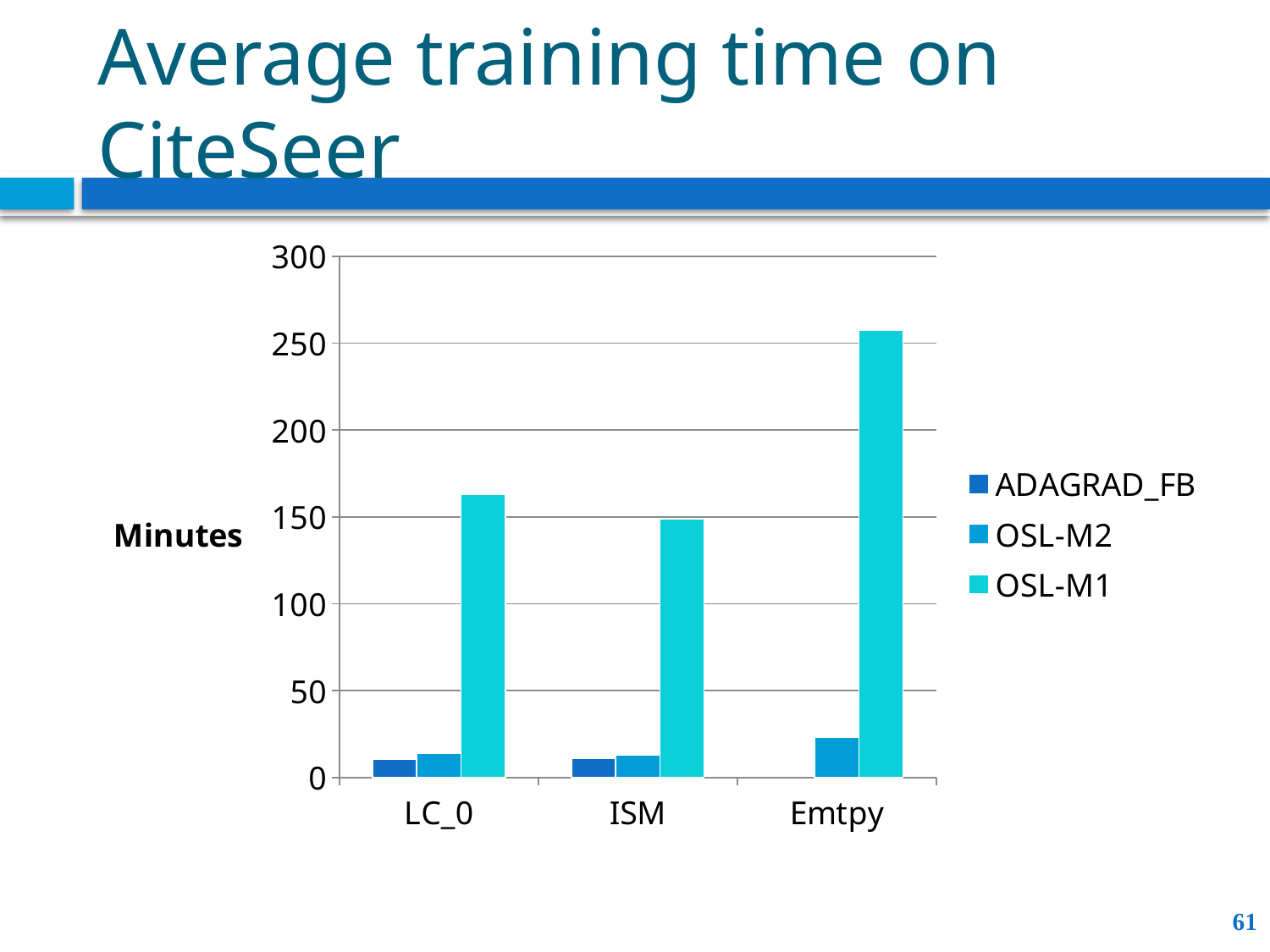
Is the OSL-M1 value for Emtpy greater or less than 250? greater How many categories are shown on the x axis? 3 How many series does the legend list? 3 What kind of chart is shown on the slide? bar chart Is the OSL-M1 value for LC_0 greater or less than 150? greater Which category has the highest OSL-M1 value? Emtpy Which series has the tallest bar in every category? OSL-M1 What is the label on the vertical axis of the chart? Minutes Is the OSL-M2 value for Emtpy greater or less than 50? less Which is larger for LC_0, the OSL-M1 value or the OSL-M2 value? OSL-M1 Which category has the lowest OSL-M1 value? ISM